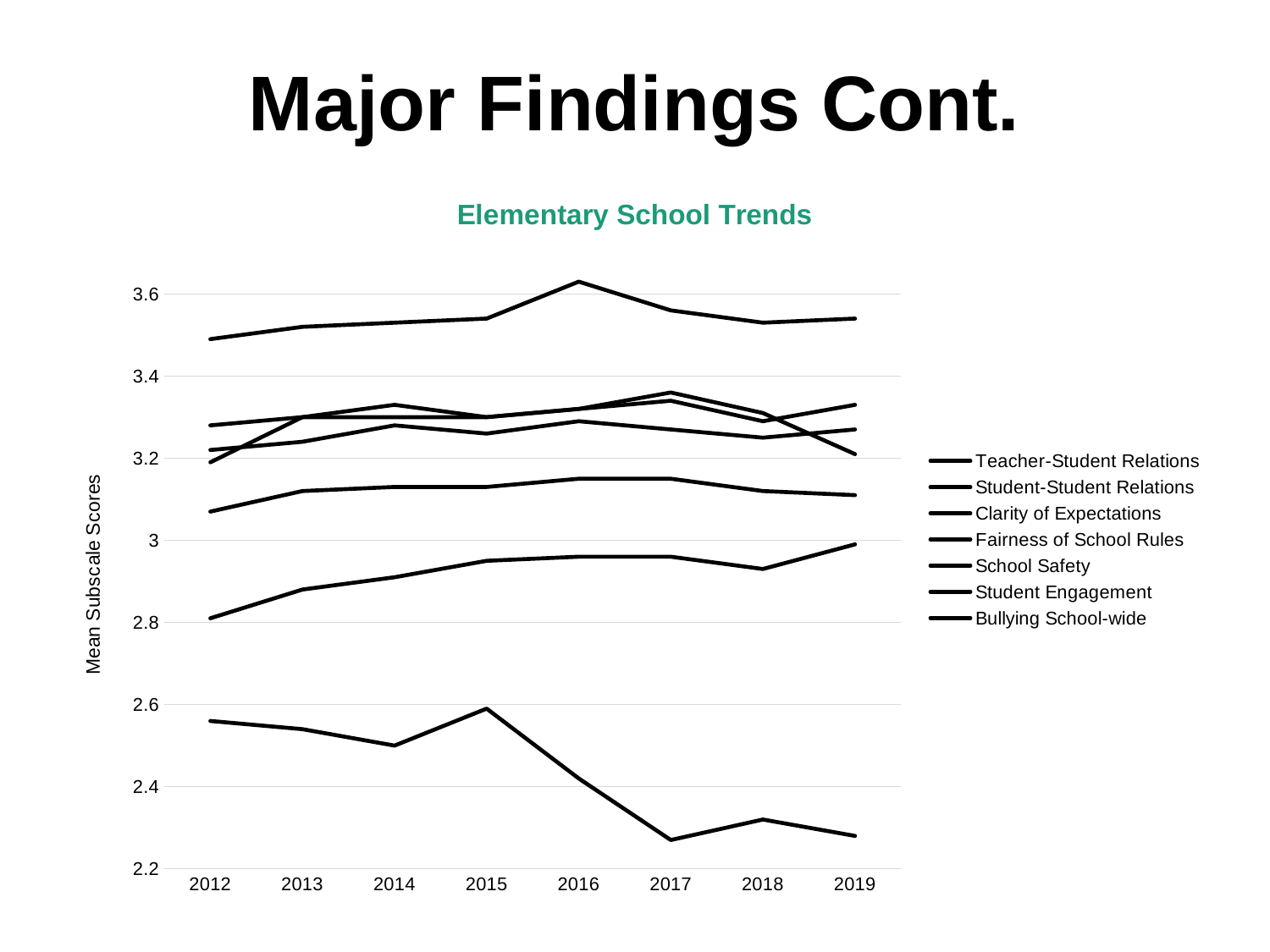
Is the value of the highest line in 2016 greater or less than 3.6? greater How many series does the legend list? 7 What is the label on the y axis? Mean Subscale Scores What kind of chart is shown on the slide? line chart Does the lowest line on the chart rise or fall between 2015 and 2017? fall Is the lowest line's value in 2019 higher or lower than its value in 2012? lower Is the value of the lowest line in 2012 greater or less than 2.4? greater Is the value of the lowest line in 2017 greater or less than 2.4? less What is the title of the chart? Elementary School Trends How many years are shown along the x axis? 8